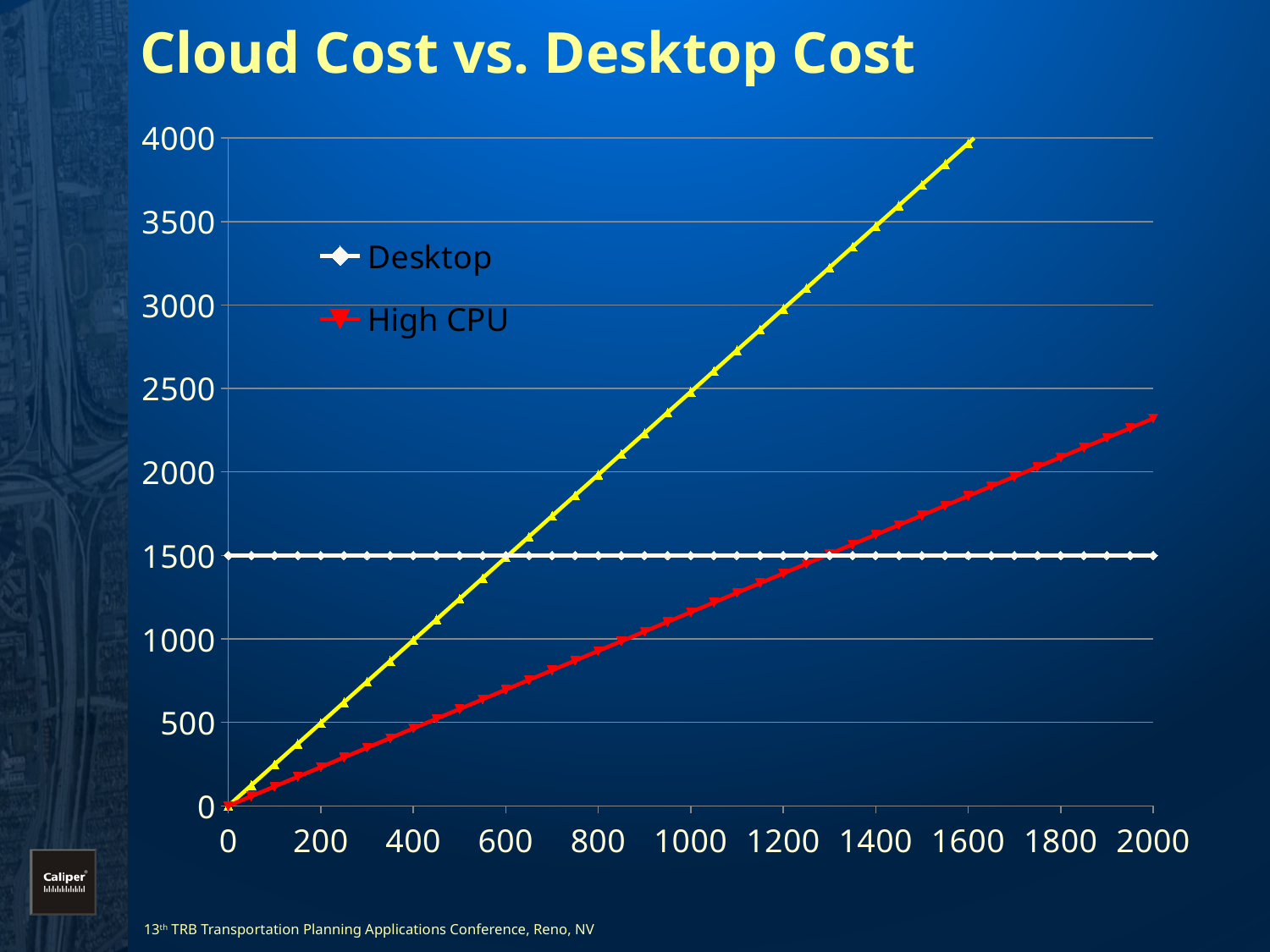
What is the title of the chart? Cloud Cost vs. Desktop Cost What is the highest value labelled on the y axis? 4000 Is the value of High CPU at x = 2000 greater or less than 2000? greater Does the Desktop series rise, fall, or stay flat along the x axis? stays flat At x = 2000, which series has the higher value, Desktop or High CPU? High CPU How many series does the legend list? 2 At x = 400, which series has the higher value, Desktop or High CPU? Desktop What is the value of the Desktop series across the x axis? 1500 What colour is the High CPU line? red Is the value of High CPU at x = 1000 greater or less than 1500? less Does the High CPU series rise or fall as the x axis increases? rises What kind of chart is shown on the slide? line chart